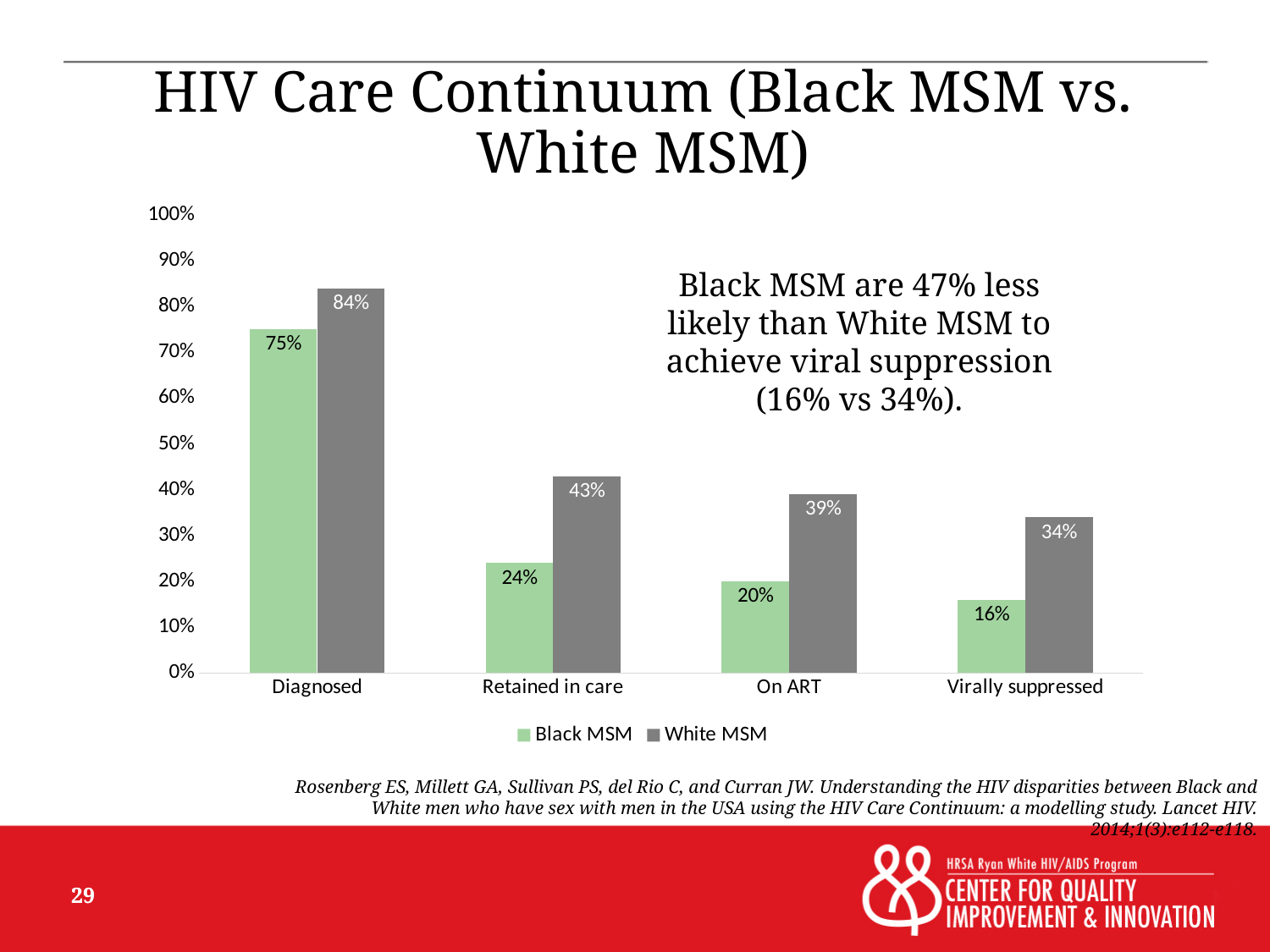
What is the value for White MSM in the Retained in care category? 43% Which category has the lowest value for Black MSM? Virally suppressed What is the value for Black MSM in the Diagnosed category? 75% What is the difference between the White MSM and Black MSM values in the Virally suppressed category? 18% Which is larger in the Retained in care category: the Black MSM value or the White MSM value? White MSM How many categories are shown on the x axis? 4 Which category has the highest value for White MSM? Diagnosed What is the difference between the White MSM and Black MSM values in the Diagnosed category? 9% How many series does the legend list? 2 What kind of chart is shown on the slide? Bar chart What is the value for White MSM in the On ART category? 39% What is the value for Black MSM in the Virally suppressed category? 16%